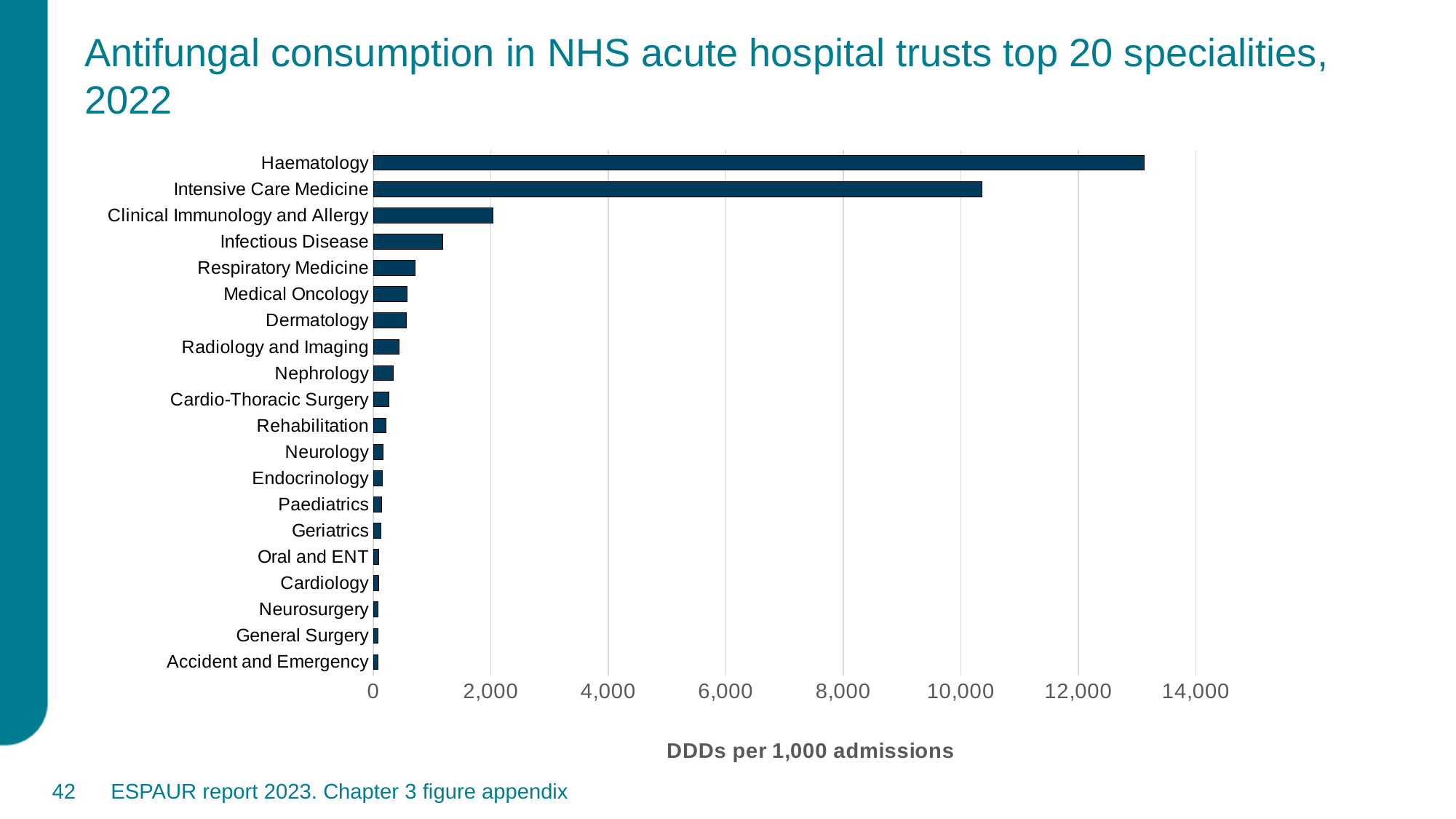
Which has the larger value, Clinical Immunology and Allergy or Infectious Disease? Clinical Immunology and Allergy What is the label on the horizontal axis of the chart? DDDs per 1,000 admissions Is the value for Clinical Immunology and Allergy greater or less than 4,000? less Is the value for Intensive Care Medicine greater or less than 10,000? greater Is the value for Haematology greater or less than 12,000? greater Which speciality has the highest antifungal consumption? Haematology How many specialities are plotted in the chart? 20 What kind of chart is shown on the slide? Bar chart Which has the larger value, Haematology or Intensive Care Medicine? Haematology Do the bar values increase or decrease going from the top of the chart to the bottom? Decrease